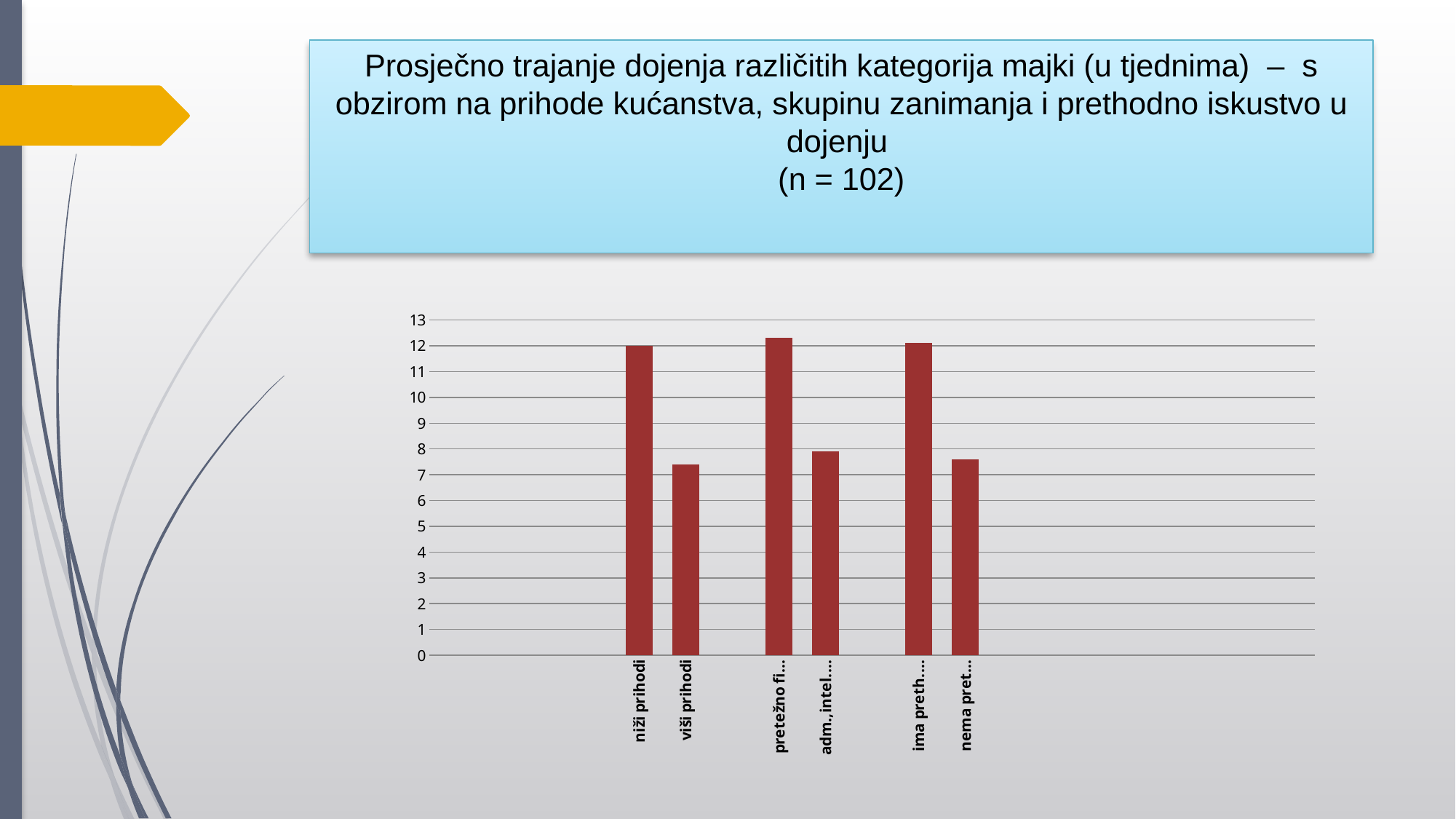
Is the value for "viši prihodi" greater or less than 8? less Is the value for "niži prihodi" greater or less than 10? greater Is the value for the bar labelled "nema pret…" greater or less than 8? less What is the highest value shown on the chart's vertical axis? 13 How many bars (categories) are plotted in the chart? 6 What kind of chart is shown on the slide? bar chart Which is larger, the value for the bar labelled "ima preth…" or the bar labelled "nema pret…"? ima preth… Which is larger, the value for the bar labelled "pretežno fi…" or the bar labelled "adm.,intel…"? pretežno fi… Which is larger, the value for "niži prihodi" or the value for "viši prihodi"? niži prihodi What sample size (n) is stated in the slide title? n = 102